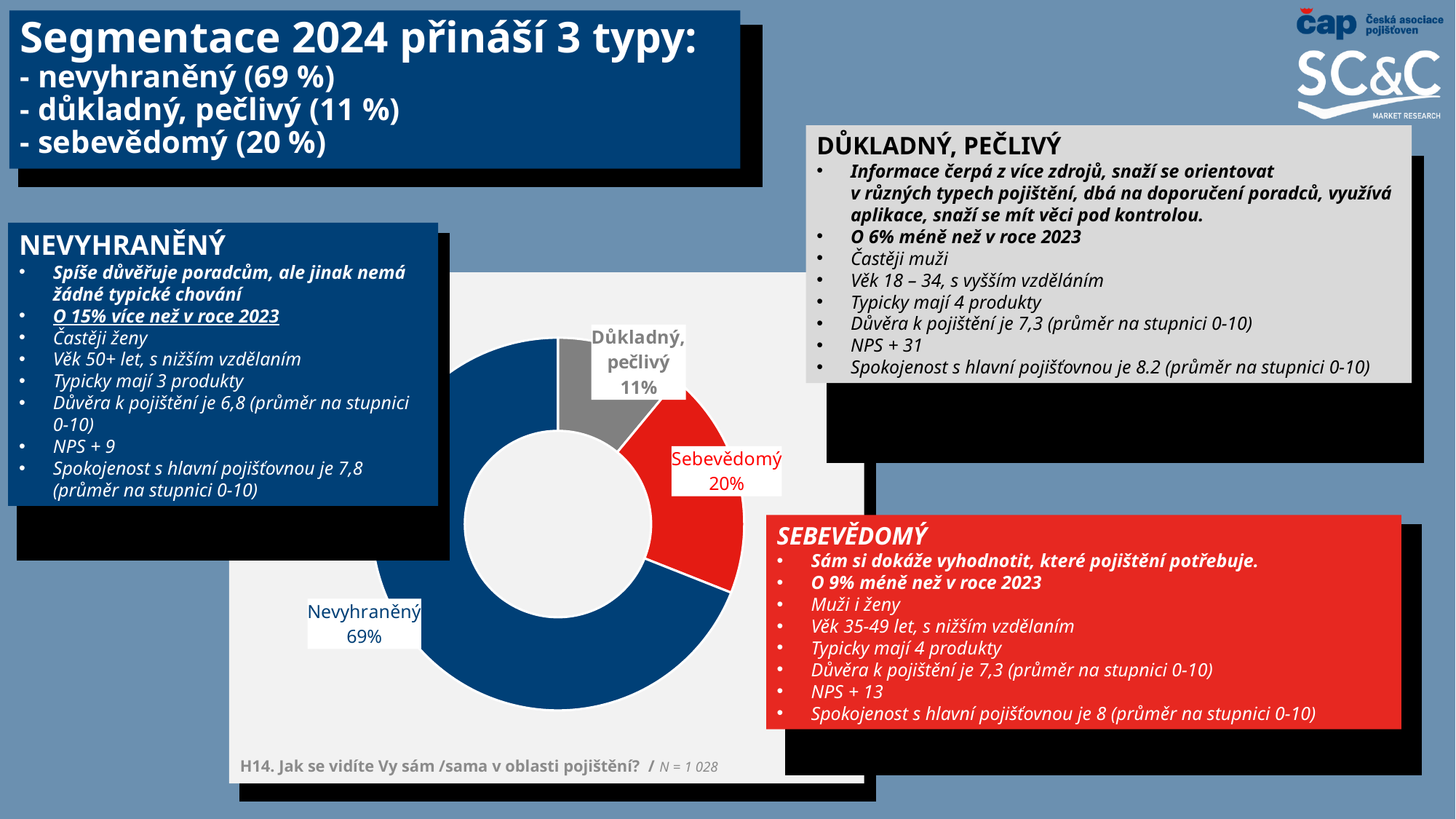
What is the difference in percentage points between the Nevyhraněný and Sebevědomý segments? 49 percentage points How many segments does the donut chart have? 3 What colour is the Sebevědomý segment in the donut chart? Red What is the difference in percentage points between the Sebevědomý and Důkladný, pečlivý segments? 9 percentage points What share of the donut chart does the Sebevědomý segment represent? 20% Which segment of the donut chart is the smallest? Důkladný, pečlivý What share of the donut chart does the Nevyhraněný segment represent? 69% Which segment of the donut chart is the largest? Nevyhraněný What type of chart is shown on the slide? Donut (pie) chart Which segment is larger in the donut chart: Sebevědomý or Důkladný, pečlivý? Sebevědomý What share of the donut chart does the Důkladný, pečlivý segment represent? 11% What is the sample size (N) stated below the donut chart? N = 1 028